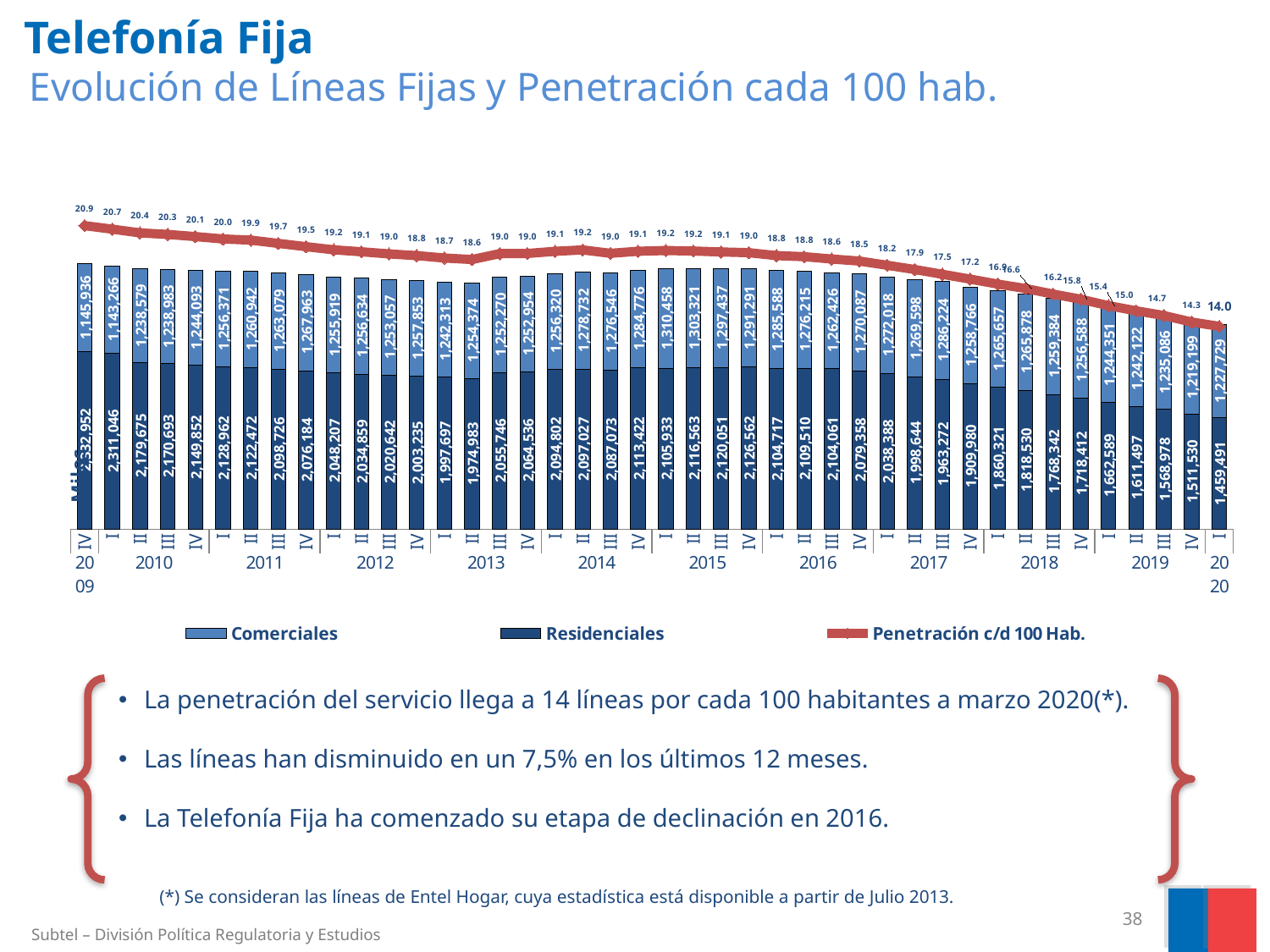
What is the Comerciales value for I 2015? 1,310,458 What kind of chart is shown on the slide? Stacked bar chart with a line What is the Residenciales value for IV 2009? 2,332,952 What is the value of Penetración c/d 100 Hab. for I 2020? 14.0 What is the total of the stacked bar for I 2020 (Comerciales plus Residenciales)? 2,687,220 Which series is shown in dark blue in the legend? Residenciales In which quarter is Penetración c/d 100 Hab. highest? IV 2009 What is the difference between the Residenciales values for I 2019 and I 2020? 203,098 How many series does the legend list? 3 Which is larger, the Comerciales value for I 2020 or for IV 2019? I 2020 In which quarter is the Residenciales value lowest? I 2020 Does Penetración c/d 100 Hab. rise or fall from I 2016 to I 2020? Fall